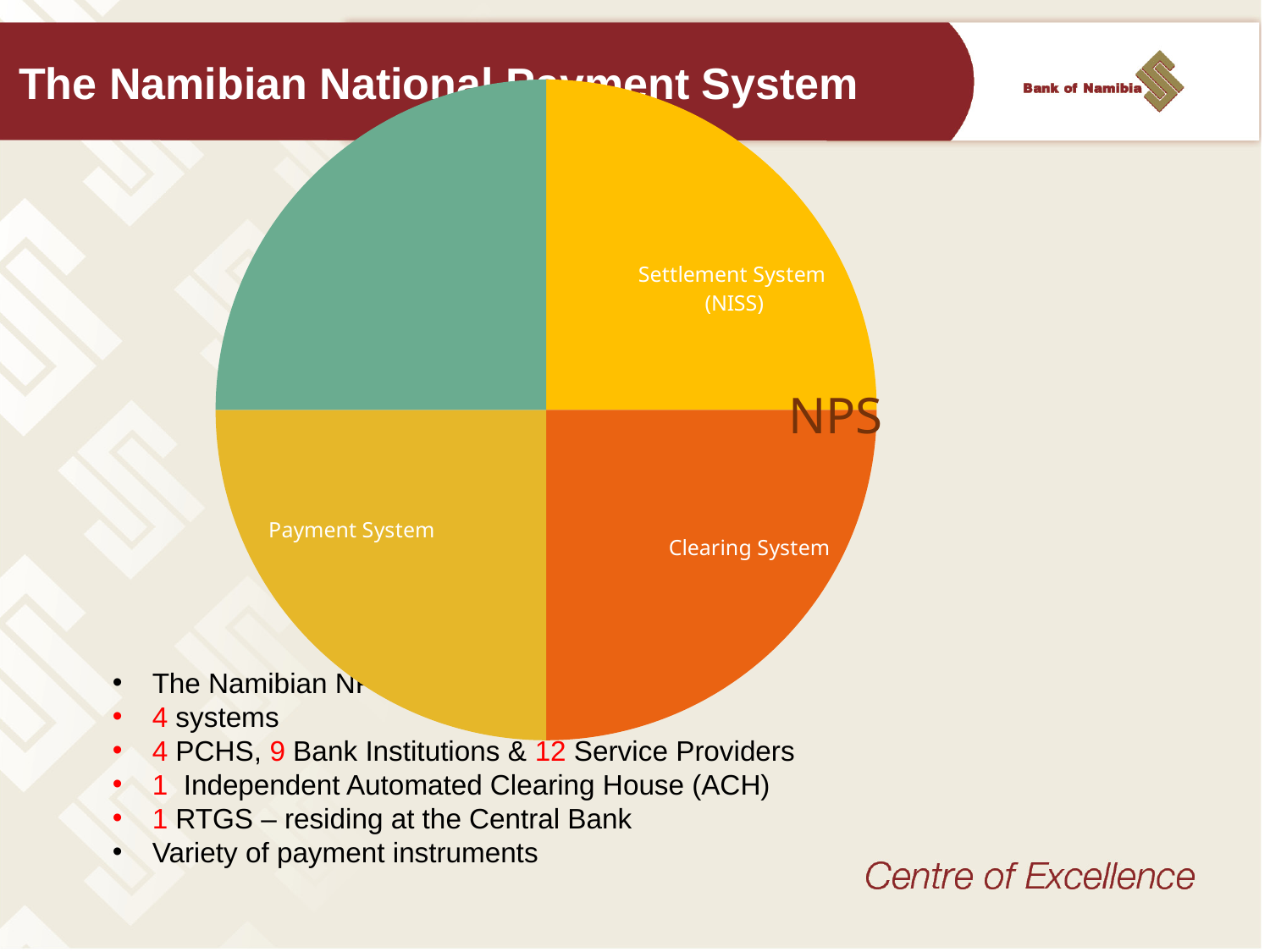
How many slices does the pie chart have? 4 How many slices of the pie chart have a readable label? 3 What is the label of the yellow slice in the upper right of the pie chart? Settlement System (NISS) What is the label of the orange slice in the lower right of the pie chart? Clearing System Which slice of the pie chart is coloured green? the unlabelled slice What is the label of the slice in the lower left of the pie chart? Payment System What kind of chart is shown on the slide? pie chart What label appears next to the pie chart as its title? NPS